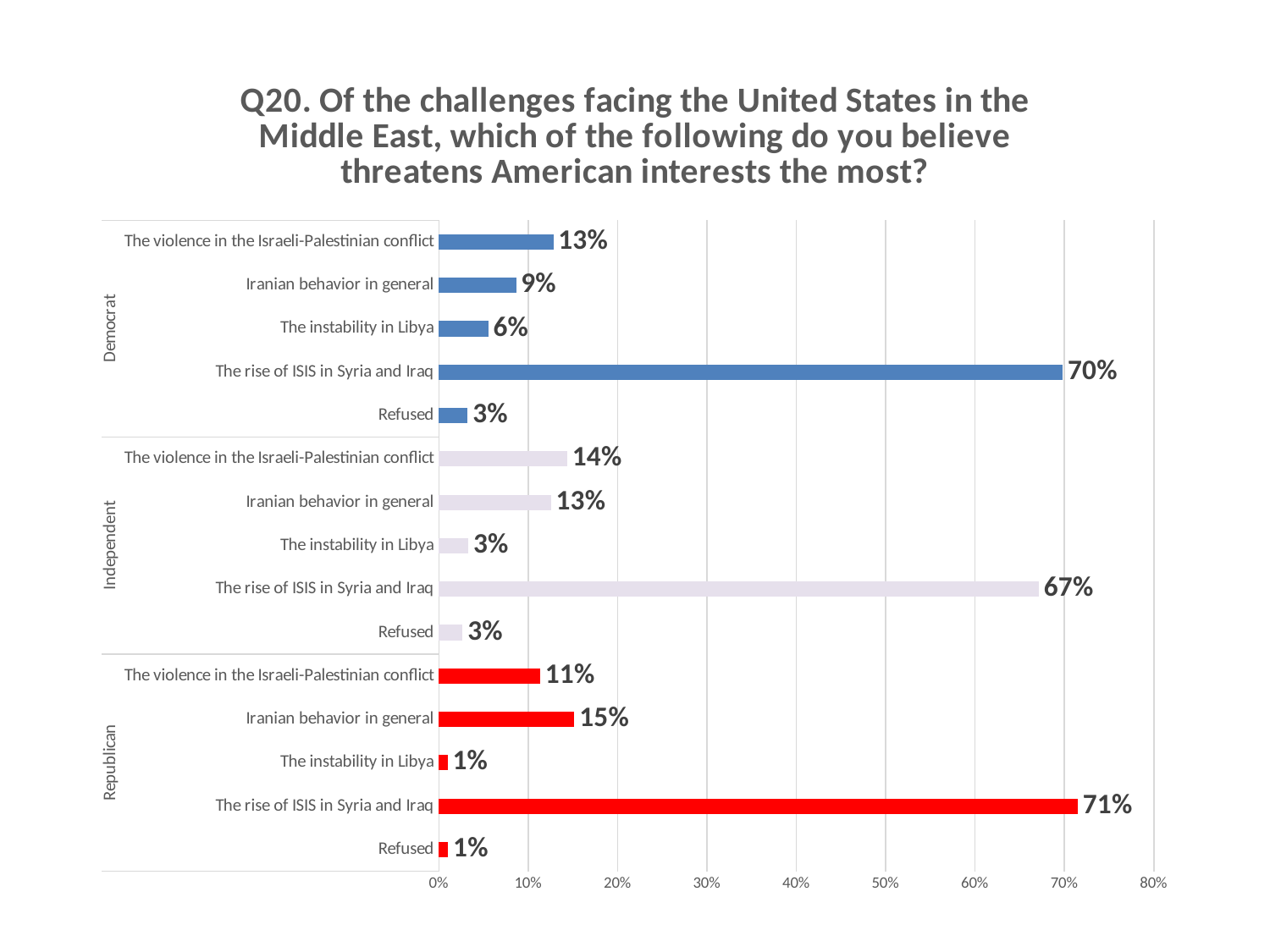
Is the Independent value for 'The rise of ISIS in Syria and Iraq' greater or less than 60%? greater Which is larger: the Democrat value for 'The violence in the Israeli-Palestinian conflict' or the Republican value for the same option? Democrat How many bars are plotted in the chart? 15 What is the difference between the Republican and Independent values for 'The rise of ISIS in Syria and Iraq'? 4% What percentage of Independents chose 'The instability in Libya'? 3% Which option has the lowest value among Democrats? Refused How many party groups are shown on the vertical axis? 3 What colour are the bars for the Republican group? Red Which option has the highest value among Republicans? The rise of ISIS in Syria and Iraq What percentage of Republicans chose 'Iranian behavior in general'? 15% What type of chart is shown on the slide? Bar chart What percentage of Democrats chose 'The rise of ISIS in Syria and Iraq'? 70%